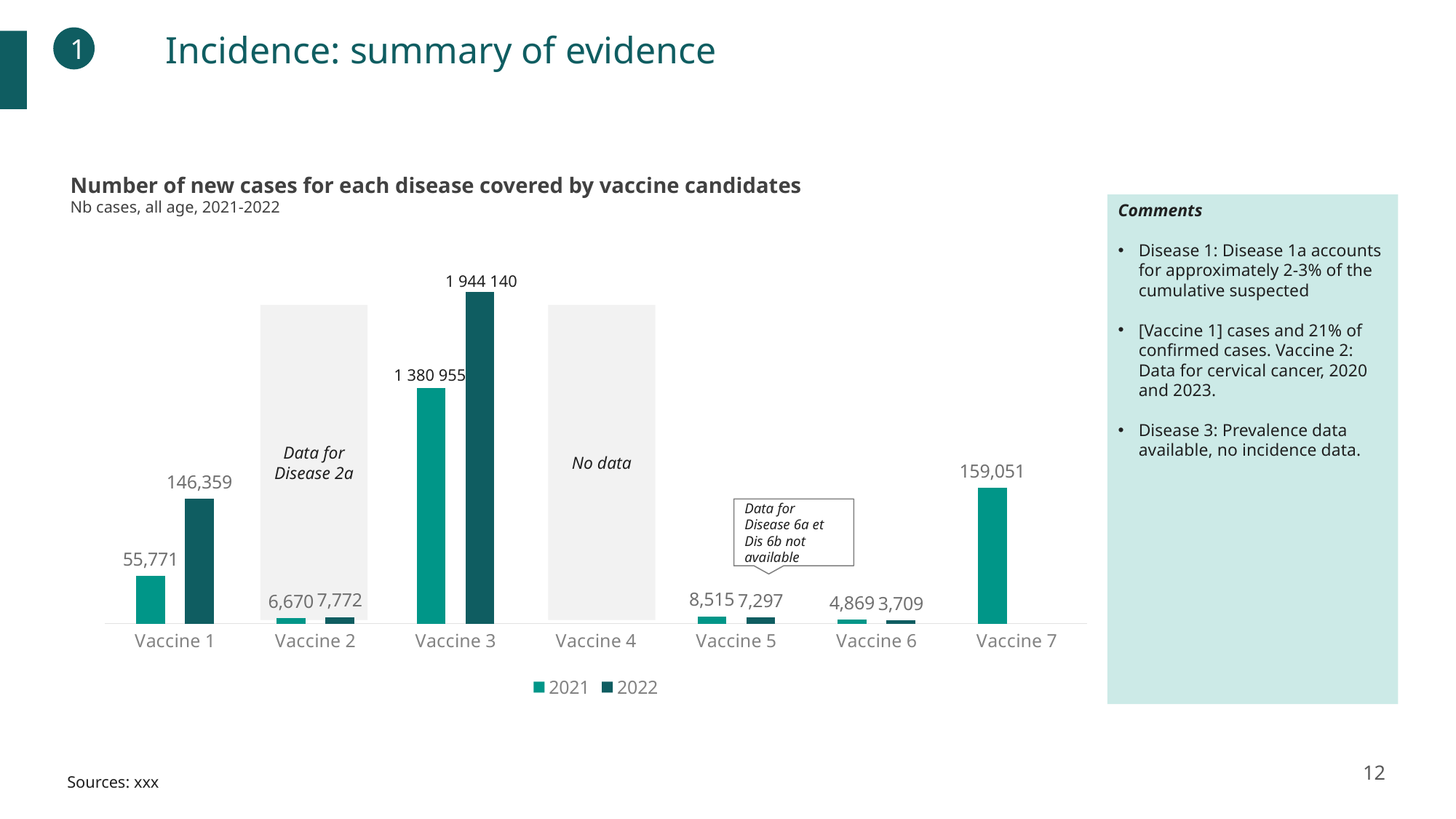
What is the difference between the 2021 and 2022 values for Vaccine 5? 1,218 Which vaccine has the highest 2022 value? Vaccine 3 What is the 2021 value for Vaccine 3? 1 380 955 Which vaccine has the lowest 2021 value among those with data shown? Vaccine 6 Which is larger for Vaccine 6: the 2021 value or the 2022 value? 2021 What is the difference between the 2022 and 2021 values for Vaccine 1? 90,588 How many vaccine categories are shown on the x axis? 7 What kind of chart is shown on the slide? Bar chart What is the 2022 value for Vaccine 5? 7,297 What is the 2021 value for Vaccine 7? 159,051 How many series does the legend list? 2 What is the 2022 value for Vaccine 1? 146,359